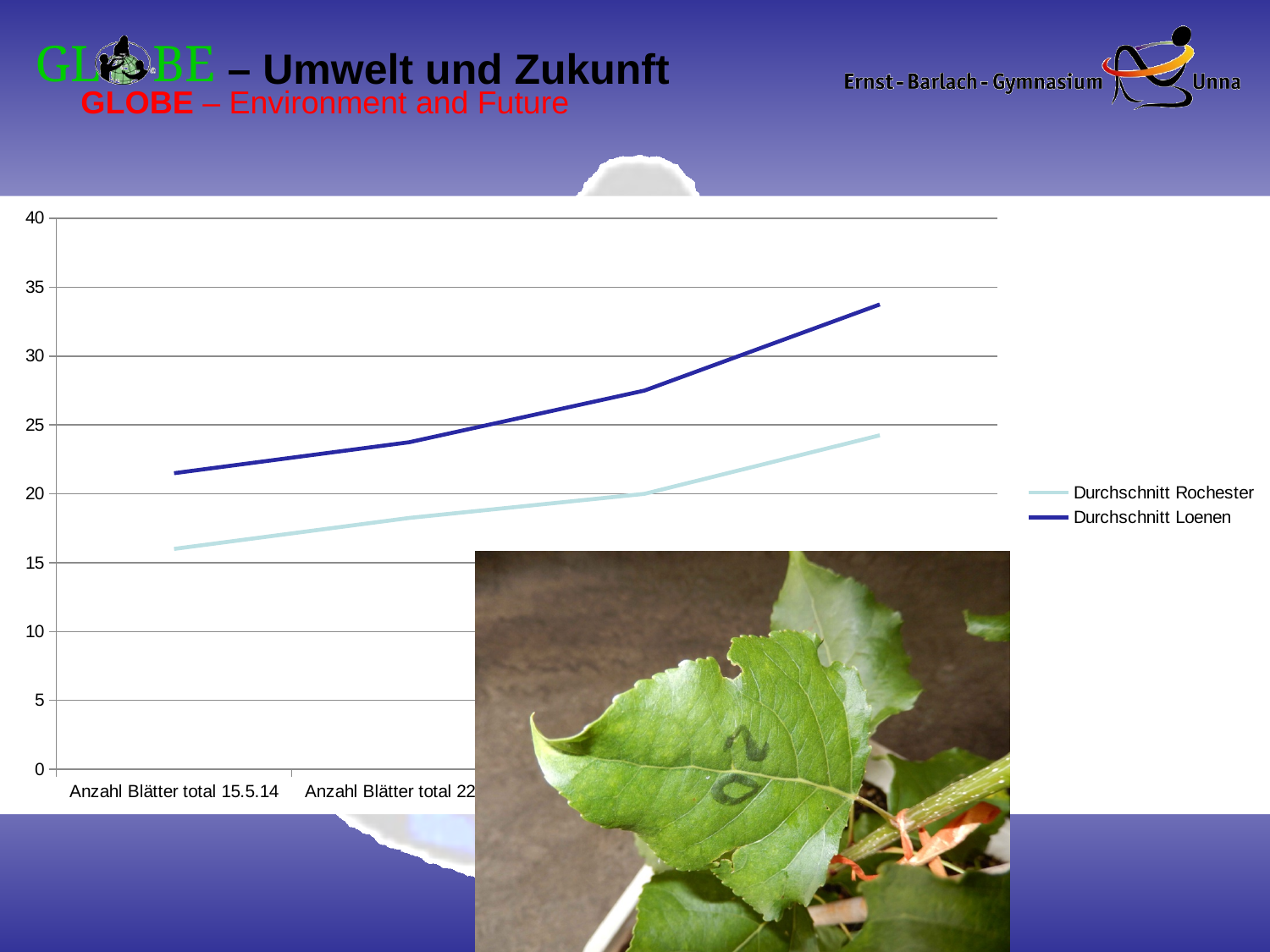
Is the value for Durchschnitt Rochester at Anzahl Blätter total 15.5.14 greater or less than 20? less Is the last value for Durchschnitt Rochester greater or less than 25? less What kind of chart is shown on the slide? line chart Do the values for Durchschnitt Rochester rise or fall along the x axis? rise How many series does the legend list? 2 Do the values for Durchschnitt Loenen rise or fall along the x axis? rise Which two series are listed in the legend? Durchschnitt Rochester and Durchschnitt Loenen How many data points does each line have? 4 Which series is drawn in dark blue? Durchschnitt Loenen Which series has the higher values throughout the chart, Durchschnitt Rochester or Durchschnitt Loenen? Durchschnitt Loenen Is the value for Durchschnitt Loenen at Anzahl Blätter total 15.5.14 greater or less than 20? greater